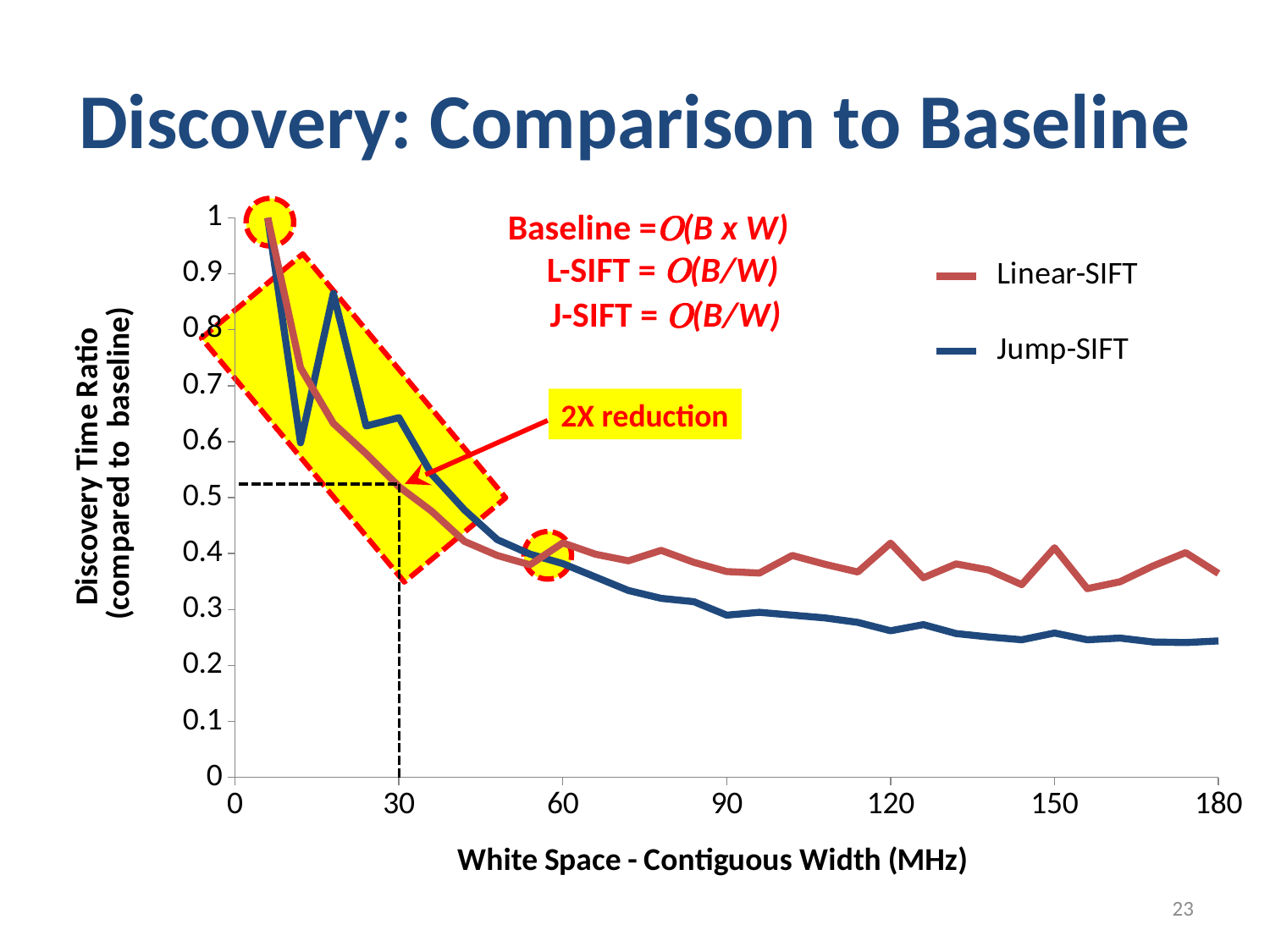
How many series does the legend list? 2 Is the Jump-SIFT value at 180 MHz greater or less than 0.3? less Is the Jump-SIFT value at 30 MHz greater or less than 0.6? greater What kind of chart is shown on the slide? line chart Is the Linear-SIFT value at 30 MHz greater or less than 0.6? less What are the two series named in the legend? Linear-SIFT and Jump-SIFT At 150 MHz, which series has the higher discovery time ratio, Linear-SIFT or Jump-SIFT? Linear-SIFT Do the Jump-SIFT values generally rise or fall as the white space contiguous width increases? fall What is the title of the x axis? White Space - Contiguous Width (MHz) Do the Linear-SIFT values generally rise or fall as the white space contiguous width increases? fall